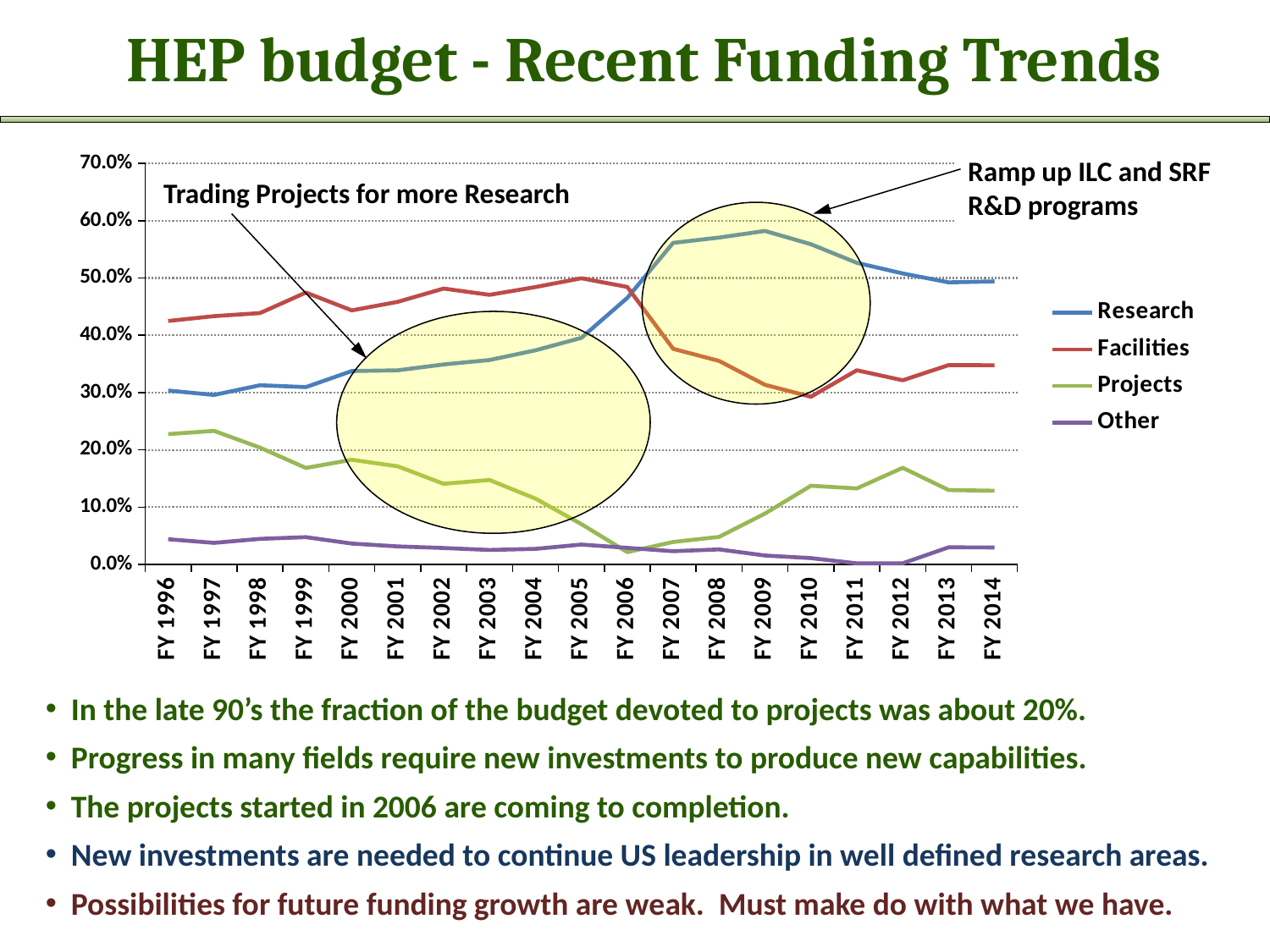
Which series has the highest value in FY 2009? Research How many fiscal years are plotted along the x axis? 19 How many series does the chart legend list? 4 Which series has the lowest value in FY 2014? Other Which series is drawn in red? Facilities In FY 2000, which is larger, the value for Research or the value for Facilities? Facilities Is the value for Projects in FY 2006 greater or less than 10%? less Is the value for Facilities in FY 2007 greater or less than 40%? less Does the Projects series rise or fall from FY 1996 to FY 2006? fall Is the value for Research in FY 2009 greater or less than 50%? greater What kind of chart is shown on the slide? line chart